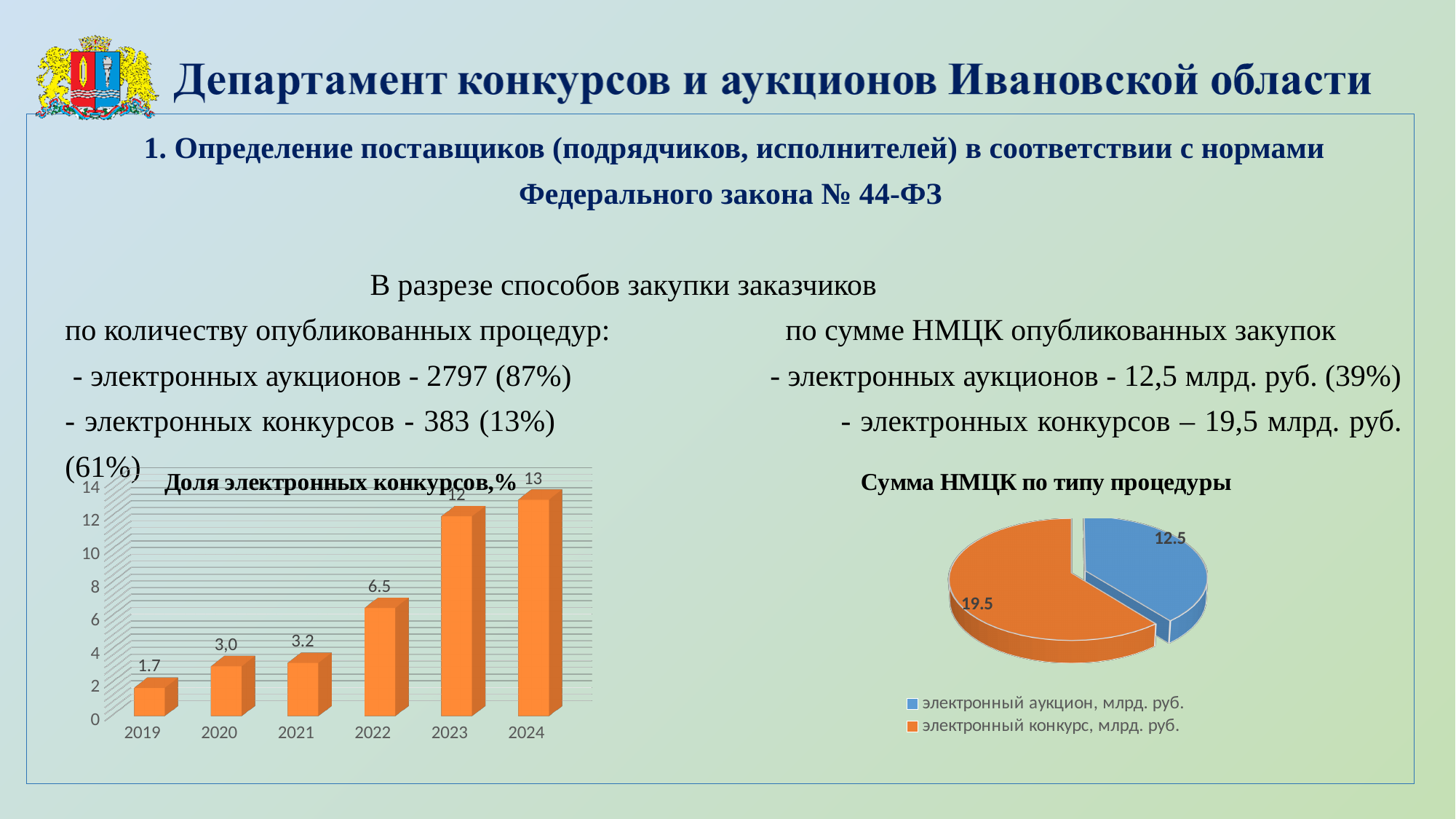
In the chart 'Доля электронных конкурсов,%', which year has the highest value? 2024 In the pie chart 'Сумма НМЦК по типу процедуры', which is larger: электронный аукцион or электронный конкурс? электронный конкурс In the pie chart 'Сумма НМЦК по типу процедуры', what is the value for электронный конкурс, млрд. руб.? 19.5 In the chart 'Доля электронных конкурсов,%', do the values rise or fall from 2019 to 2024? rise In the chart 'Доля электронных конкурсов,%', what is the value for 2024? 13 How many entries does the legend of the pie chart 'Сумма НМЦК по типу процедуры' list? 2 In the chart 'Доля электронных конкурсов,%', what is the difference between the values for 2023 and 2022? 5.5 What kind of chart is 'Доля электронных конкурсов,%'? bar chart In the chart 'Доля электронных конкурсов,%', what is the value for 2019? 1.7 In the chart 'Доля электронных конкурсов,%', what is the value for 2022? 6.5 In the chart 'Доля электронных конкурсов,%', which year has the lowest value? 2019 How many years are shown in the chart 'Доля электронных конкурсов,%'? 6